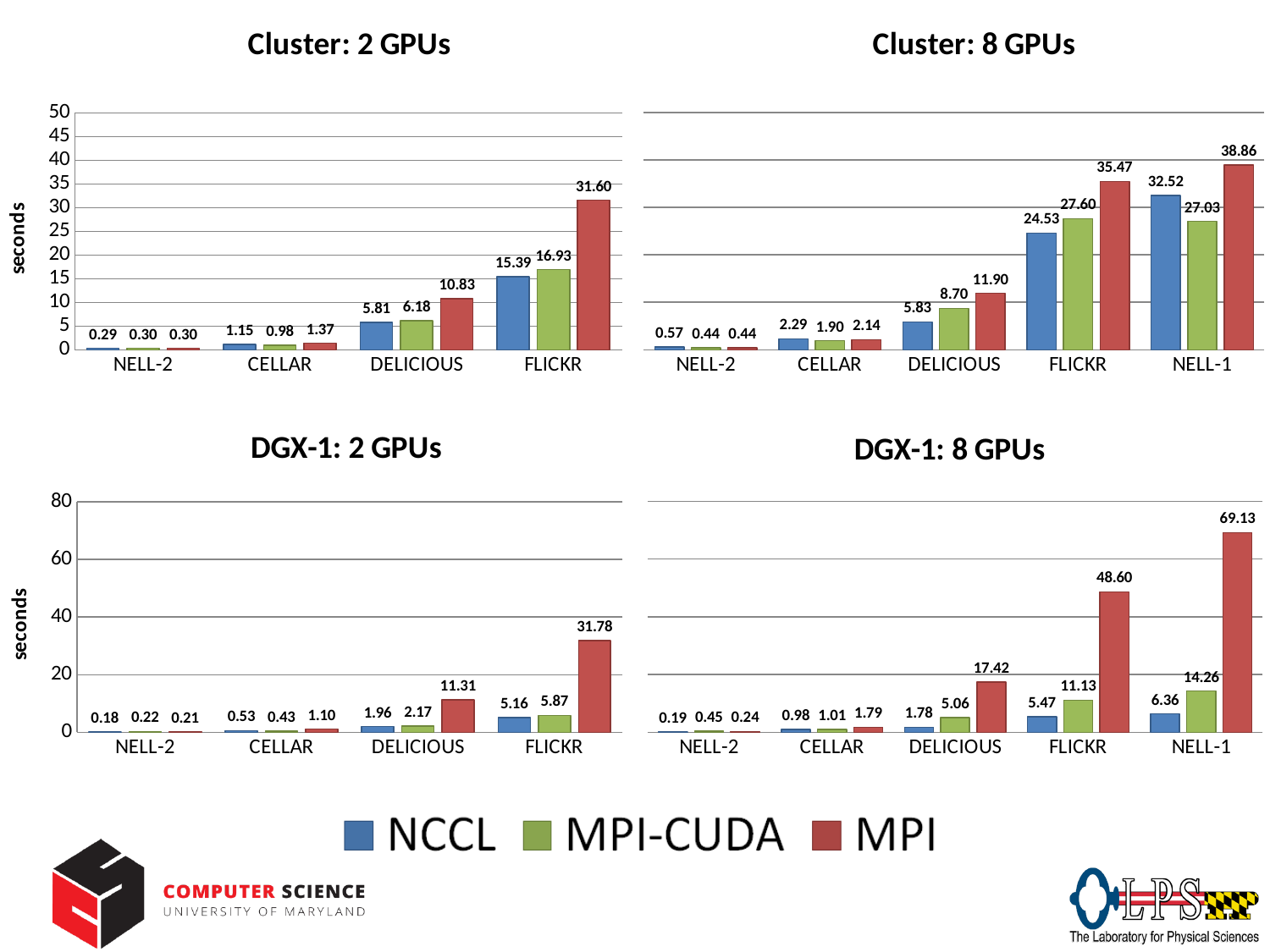
In the "DGX-1: 2 GPUs" chart, which category has the highest MPI value? FLICKR In the "Cluster: 8 GPUs" chart, which category has the lowest NCCL value? NELL-2 How many series does the legend list? 3 In the "Cluster: 8 GPUs" chart, which is larger for NELL-1: the NCCL value or the MPI-CUDA value? NCCL In the "DGX-1: 8 GPUs" chart, what is the difference between the MPI and NCCL values for NELL-1? 62.77 What kind of chart is the "DGX-1: 2 GPUs" chart? bar chart In the "Cluster: 8 GPUs" chart, what is the NCCL value for NELL-1? 32.52 What is the y-axis label on the "Cluster: 2 GPUs" chart? seconds In the "DGX-1: 8 GPUs" chart, what is the MPI-CUDA value for FLICKR? 11.13 How many categories are shown on the x axis of the "Cluster: 8 GPUs" chart? 5 In the "Cluster: 2 GPUs" chart, what is the MPI value for FLICKR? 31.60 In the "DGX-1: 8 GPUs" chart, is the MPI value for FLICKR greater or less than 40? greater